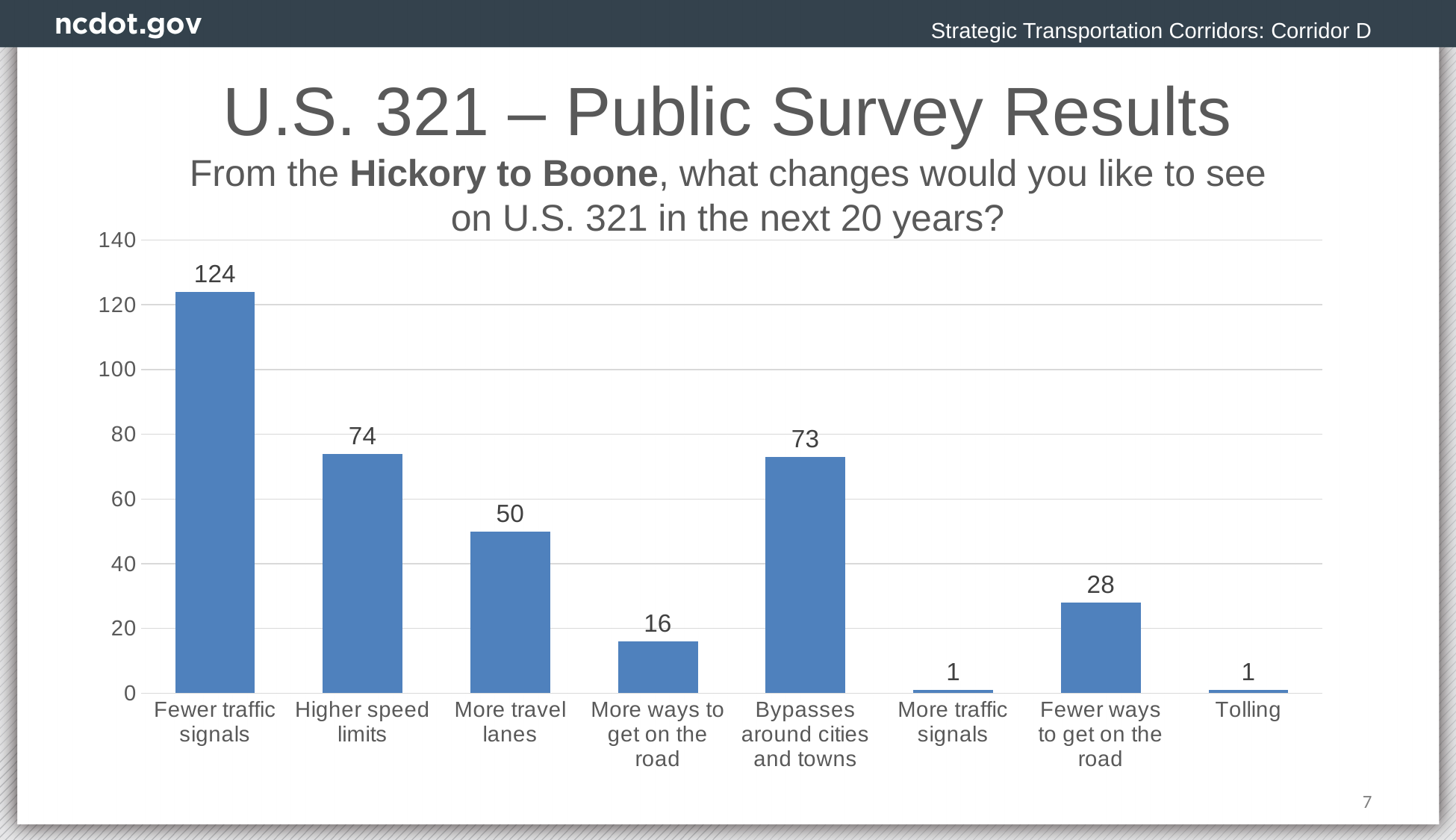
Which category has the highest value? Fewer traffic signals Is the value for "Fewer traffic signals" greater or less than 100? greater What is the value for "Tolling"? 1 What kind of chart is shown on the slide? Bar chart What is the value for "Bypasses around cities and towns"? 73 What is the value for "Fewer ways to get on the road"? 28 What is the highest value shown on the y axis? 140 Which is larger, "Higher speed limits" or "More travel lanes"? Higher speed limits How many categories are shown on the x axis? 8 What is the difference between "Fewer traffic signals" and "Higher speed limits"? 50 What is the value for "Fewer traffic signals"? 124 What is the difference between "More travel lanes" and "More ways to get on the road"? 34